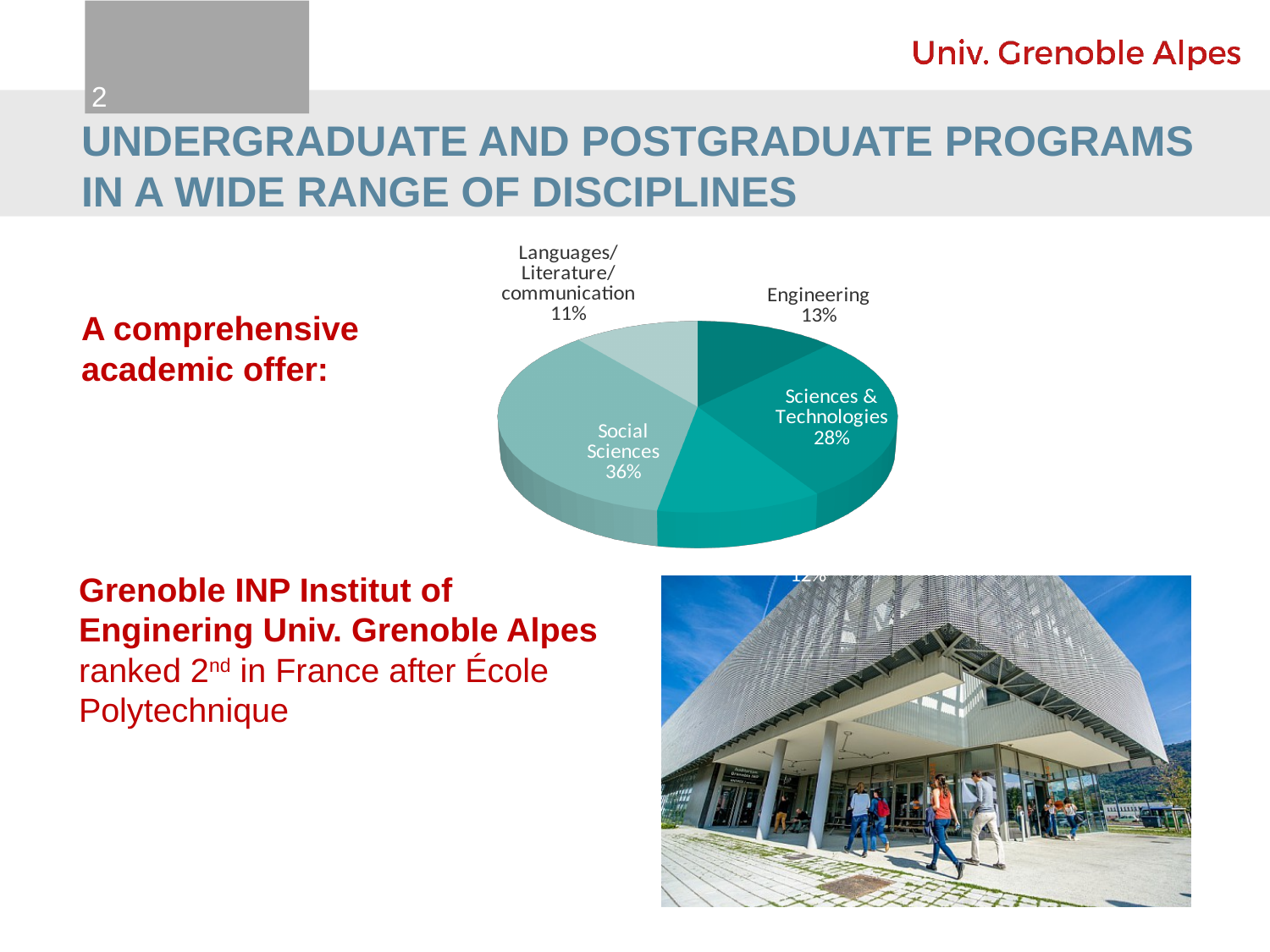
What is the difference in percentage points between Sciences & Technologies and Engineering? 15 What share does Sciences & Technologies have in the pie chart? 28% Which is larger, Social Sciences or Sciences & Technologies? Social Sciences What percentage is shown for Languages/Literature/communication? 11% What kind of chart is shown on the slide? Pie chart How many percentage points larger is Social Sciences than Sciences & Technologies? 8 How many slices does the pie chart have? 5 What percentage of the pie chart is Social Sciences? 36% Which is larger, the Engineering slice or the Languages/Literature/communication slice? Engineering Which discipline has the smallest slice of the pie chart? Languages/Literature/communication What percentage is shown for Engineering in the pie chart? 13% Which discipline has the largest slice of the pie chart? Social Sciences